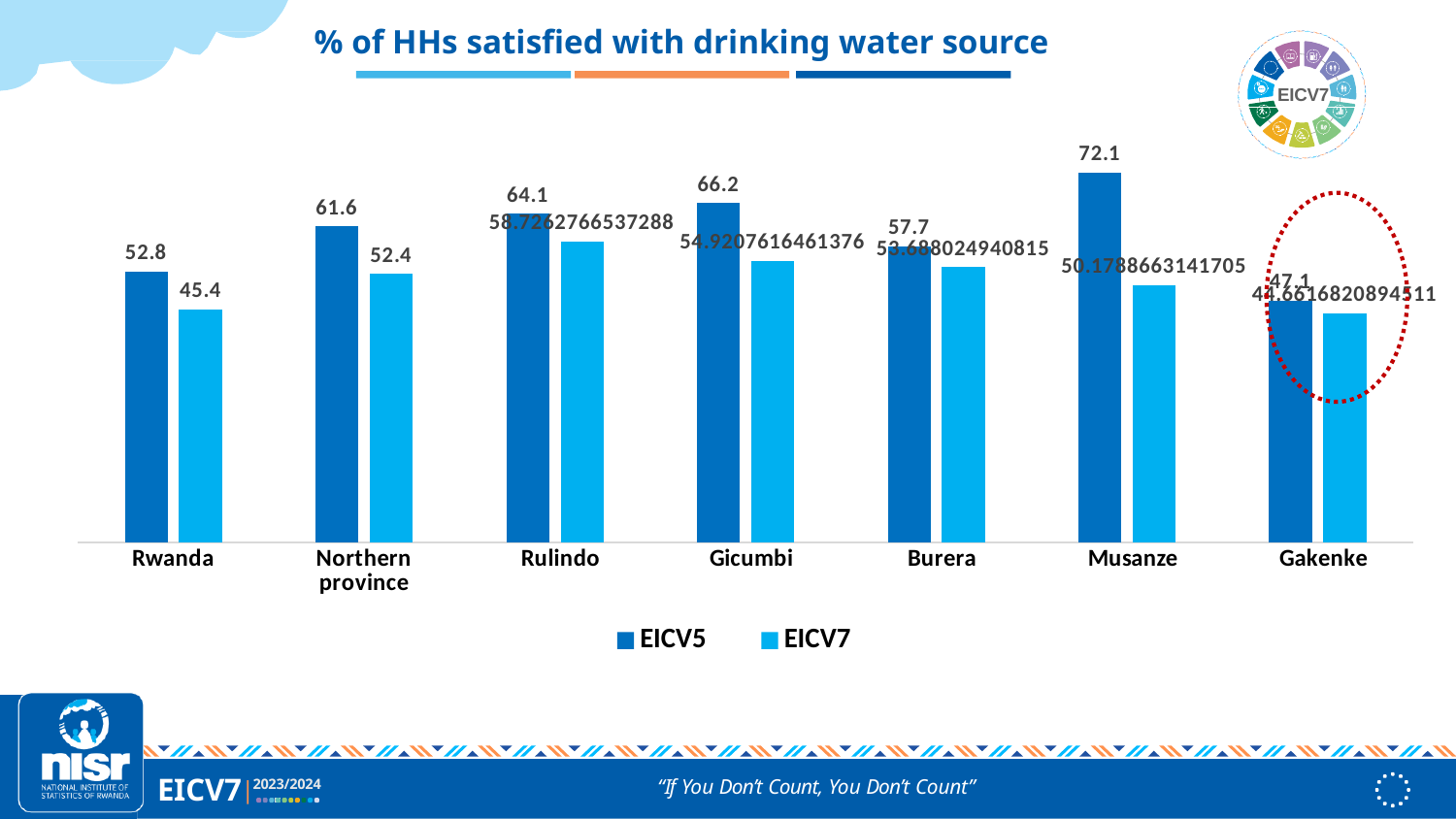
How many categories are shown on the x axis? 7 What is the EICV5 value for Musanze? 72.1 Which category has the highest EICV5 value? Musanze What is the EICV7 value for Rwanda? 45.4 What is the difference between the EICV5 and EICV7 values for Rwanda? 7.4 What is the EICV5 value for Gicumbi? 66.2 What is the EICV7 value for Musanze? 50.1788663141705 How many series does the legend list? 2 What is the difference between the EICV5 and EICV7 values for Northern province? 9.2 Which category has the lowest EICV5 value? Gakenke What is the EICV5 value for Rwanda? 52.8 Which is larger, the EICV5 value for Northern province or the EICV5 value for Rwanda? Northern province